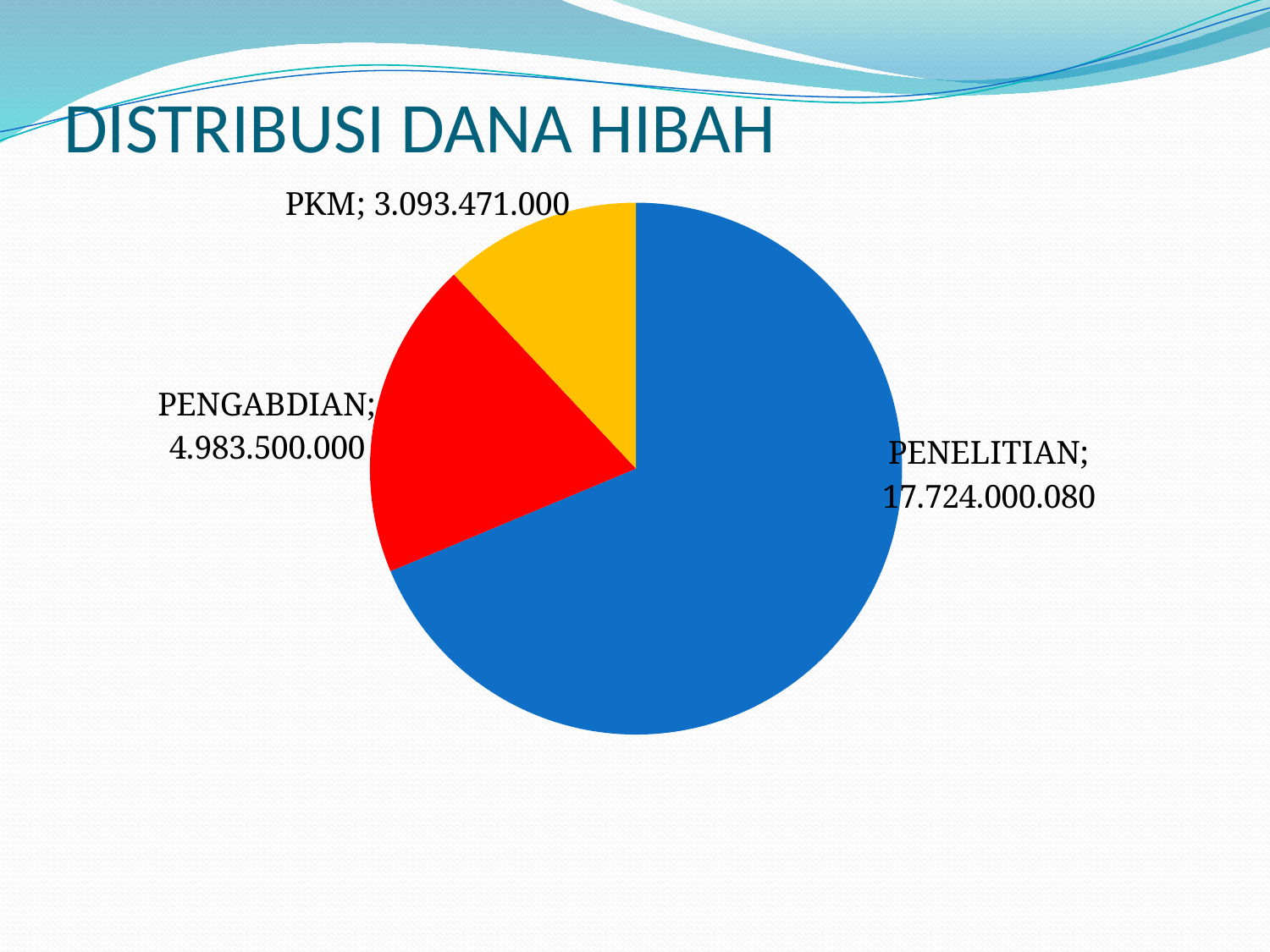
How many categories are shown in the pie chart? 3 What is the value for PENELITIAN? 17.724.000.080 What is the difference between the values for PENGABDIAN and PKM? 1.890.029.000 What is the total of all three slices of the pie? 25.800.971.080 What kind of chart is shown on the slide? Pie chart What is the value for PKM? 3.093.471.000 Which category has the largest slice of the pie? PENELITIAN Which is larger, the value for PENGABDIAN or the value for PKM? PENGABDIAN Which category has the smallest slice of the pie? PKM What is the difference between the values for PENELITIAN and PENGABDIAN? 12.740.500.080 What is the title of the chart on the slide? DISTRIBUSI DANA HIBAH What is the value for PENGABDIAN? 4.983.500.000